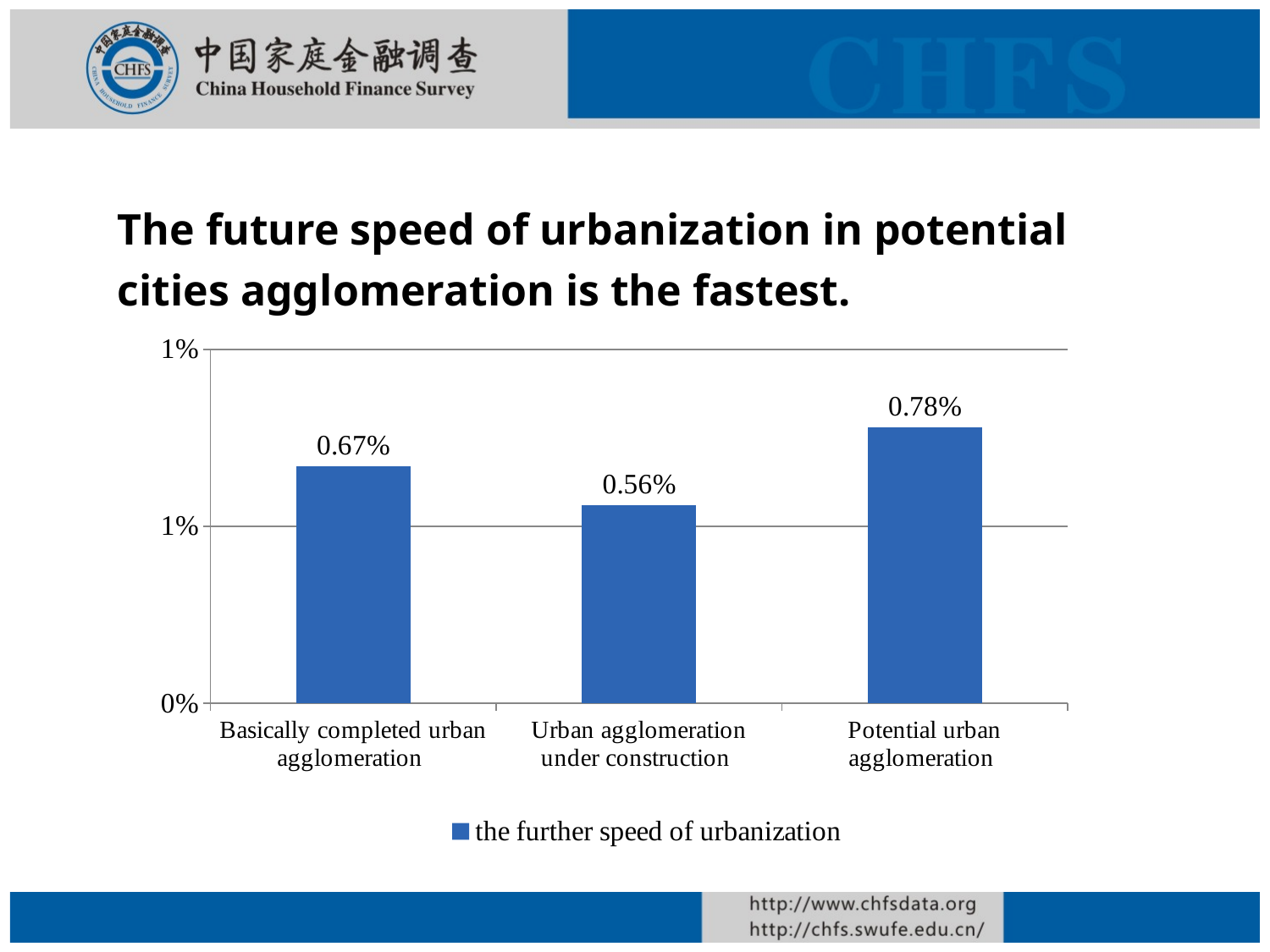
What is the difference between the values for Potential urban agglomeration and Basically completed urban agglomeration? 0.11% What kind of chart is shown on the slide? Bar chart What is the value for Urban agglomeration under construction? 0.56% What is the value for Potential urban agglomeration? 0.78% Which category has the lowest value? Urban agglomeration under construction What is the legend entry for the series shown? the further speed of urbanization What is the difference between the values for Potential urban agglomeration and Urban agglomeration under construction? 0.22% Which category has the highest value? Potential urban agglomeration How many series does the legend list? 1 Which is larger, the value for Basically completed urban agglomeration or the value for Urban agglomeration under construction? Basically completed urban agglomeration How many categories are shown on the x axis? 3 What is the value for Basically completed urban agglomeration? 0.67%